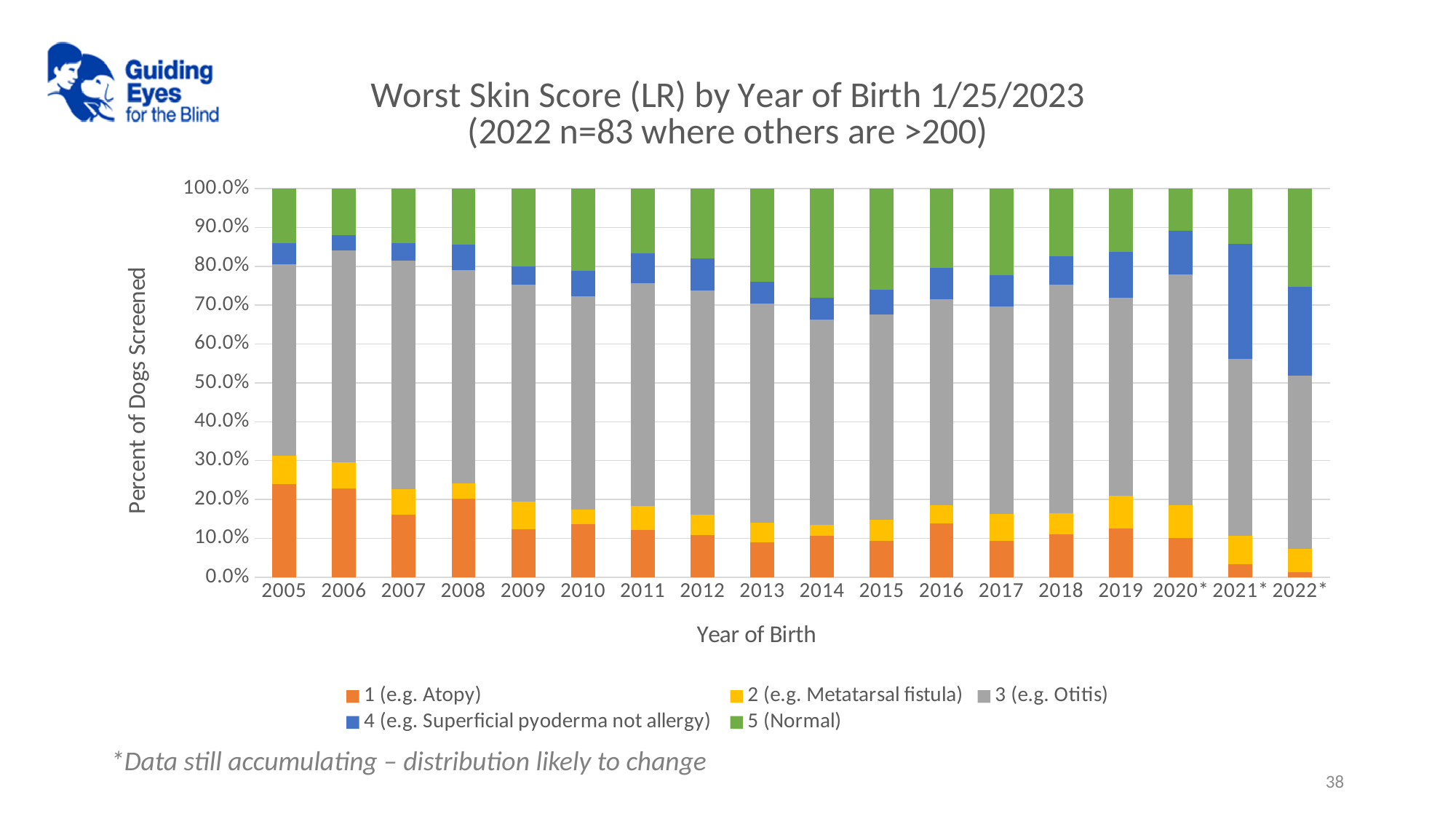
Does the share of score 1 (e.g. Atopy) generally rise or fall from 2005 to 2022*? fall Which year has the largest share of score 4 (e.g. Superficial pyoderma not allergy)? 2021* What is the label of the x axis? Year of Birth Is the share of score 1 (e.g. Atopy) for 2021* greater or less than 10.0%? less Is the share of score 4 (e.g. Superficial pyoderma not allergy) for 2021* greater or less than 20.0%? greater What kind of chart is shown on the slide? Stacked bar chart Which year has the smallest share of score 1 (e.g. Atopy)? 2022* Which year has the larger share of score 1 (e.g. Atopy), 2005 or 2021*? 2005 How many years of birth are shown along the x axis? 18 What is the total of the stacked bar for 2010? 100.0% Is the share of score 1 (e.g. Atopy) for 2005 greater or less than 20.0%? greater How many series does the legend list? 5